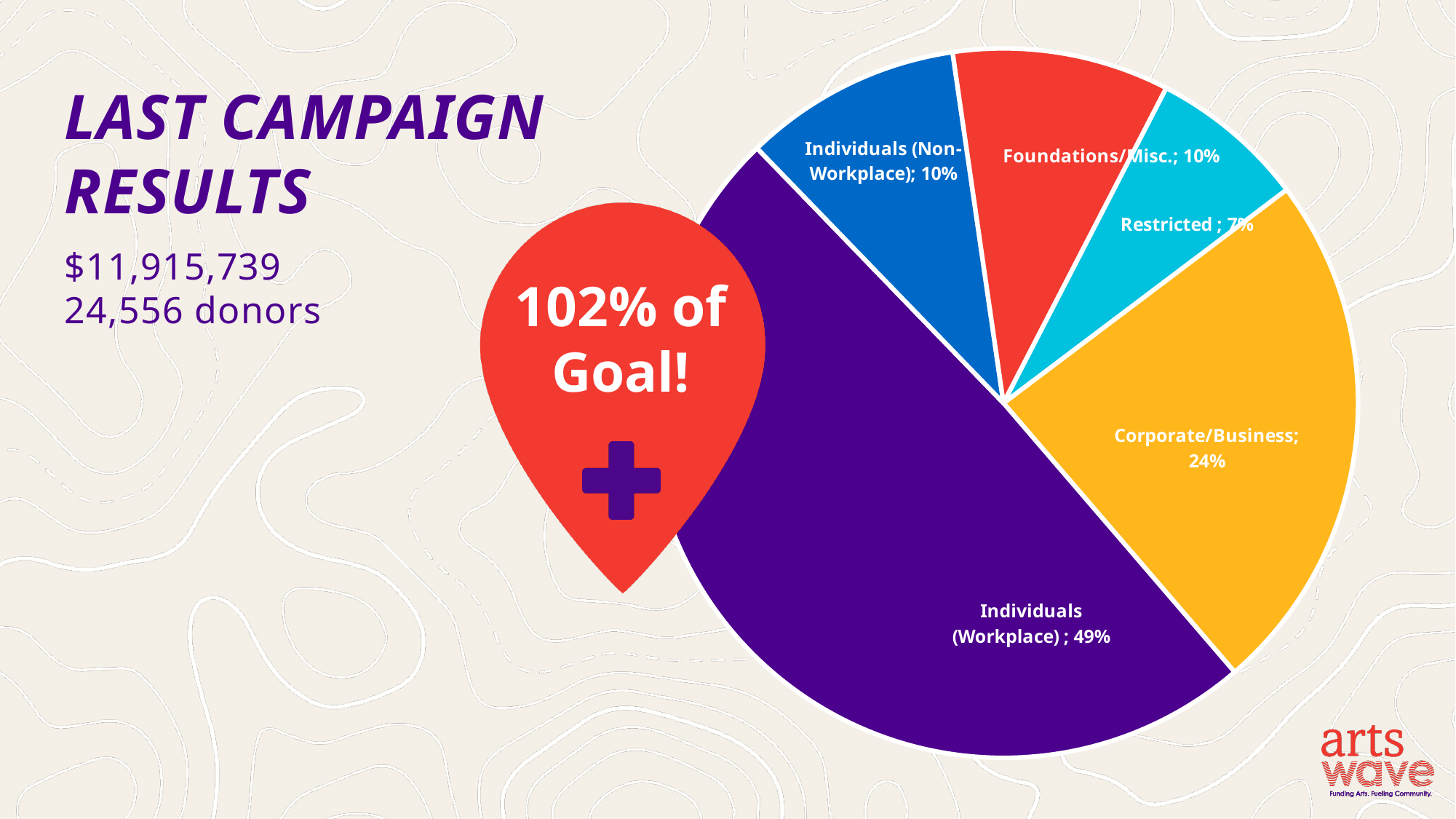
What share of the pie is Restricted? 7% What share of the pie is Individuals (Workplace)? 49% Which slice of the pie is the largest? Individuals (Workplace) What share of the pie is Individuals (Non-Workplace)? 10% Which is larger, Corporate/Business or Foundations/Misc.? Corporate/Business How many slices does the pie chart have? 5 What is the difference in percentage points between Individuals (Workplace) and Corporate/Business? 25 Which slice of the pie is the smallest? Restricted What colour is the Corporate/Business slice? yellow What kind of chart is shown on the slide? pie chart